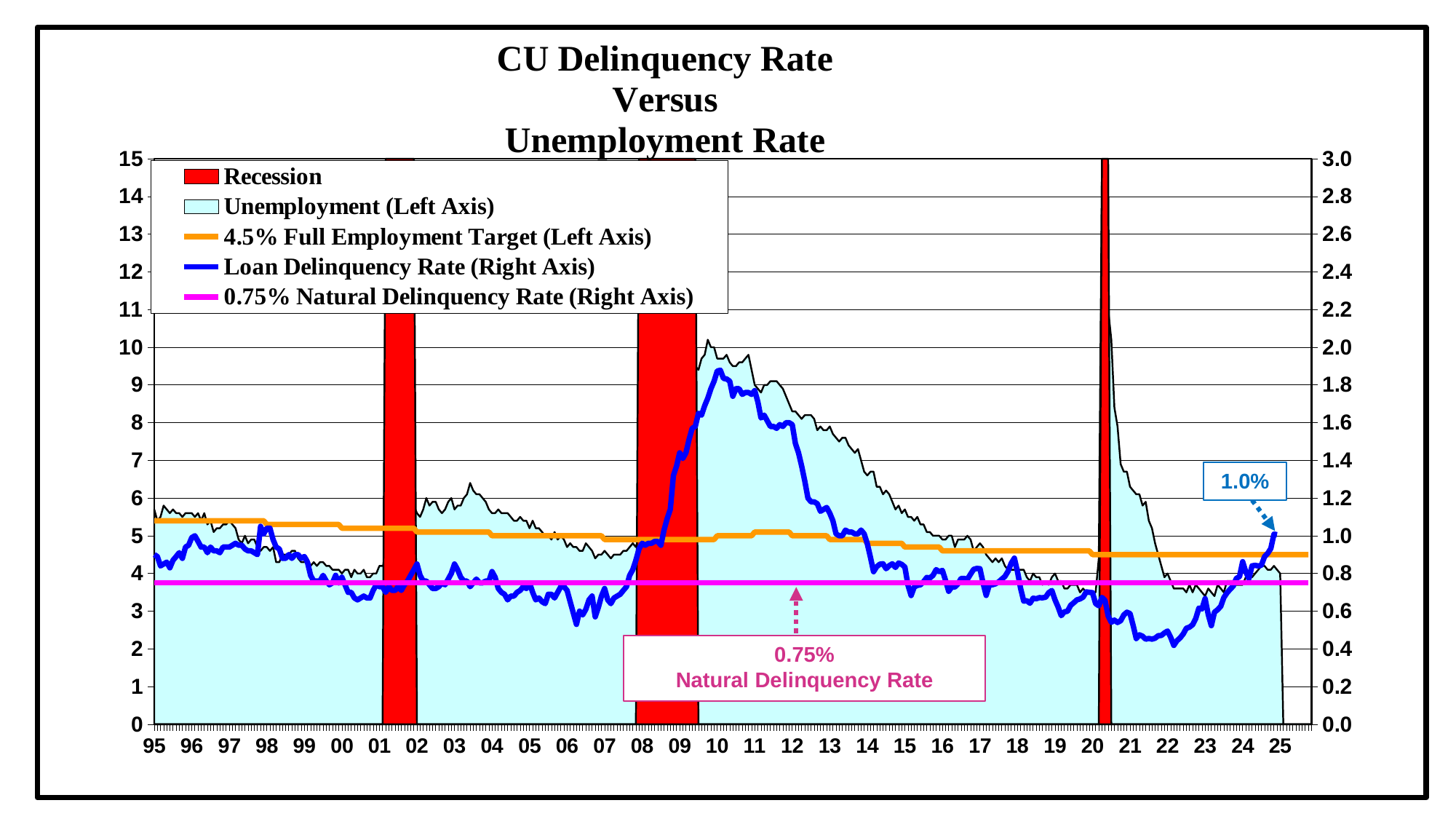
Is the peak Loan Delinquency Rate around 2010 greater or less than 1.6 on the right axis? greater What is the title of the chart? CU Delinquency Rate Versus Unemployment Rate Is the Loan Delinquency Rate in 2022 greater or less than 0.6 on the right axis? less Is the peak unemployment rate around 2020 greater or less than 12 on the left axis? greater What is the value of the Full Employment Target line according to the legend? 4.5% Does the unemployment rate rise or fall from 2010 to 2019? fall How many entries does the chart's legend list? 5 Does the Loan Delinquency Rate rise or fall from 2022 to 2025? rise What is the value of the Natural Delinquency Rate line shown on the chart? 0.75% Which is higher, the Loan Delinquency Rate in 2010 or in 2022? 2010 What is the labeled value of the Loan Delinquency Rate at the end of the series in 2025? 1.0% How many recession periods are shaded on the chart? 3